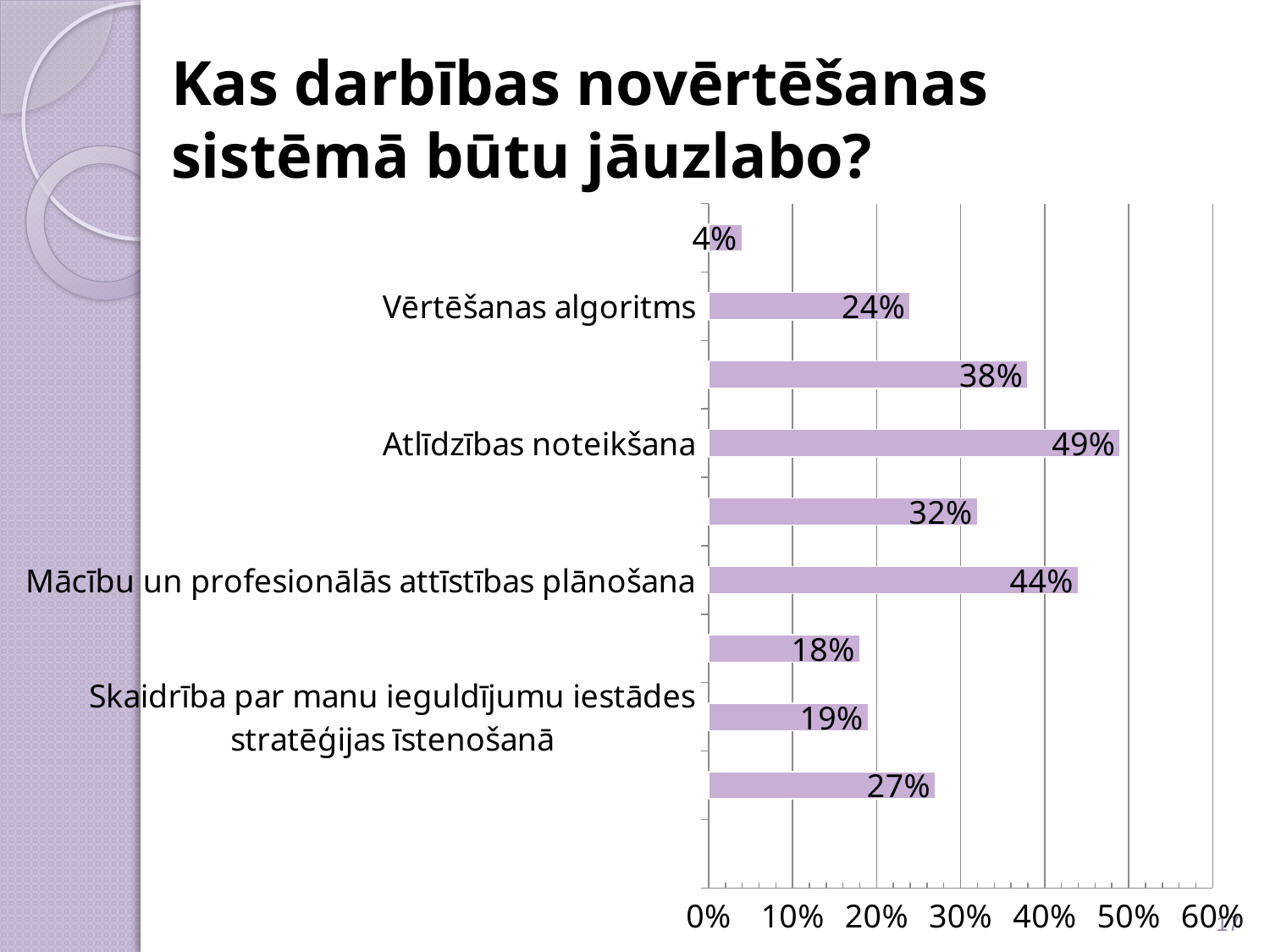
What is the difference between the values for Atlīdzības noteikšana and Mācību un profesionālās attīstības plānošana? 5% What is the title of the slide containing the chart? Kas darbības novērtēšanas sistēmā būtu jāuzlabo? Which is larger, the value for Vērtēšanas algoritms or the value for Skaidrība par manu ieguldījumu iestādes stratēģijas īstenošanā? Vērtēšanas algoritms Is the value for Mācību un profesionālās attīstības plānošana greater or less than 40%? greater What is the value for Vērtēšanas algoritms? 24% What is the value for Mācību un profesionālās attīstības plānošana? 44% Which labelled category has the highest value? Atlīdzības noteikšana What is the value for Atlīdzības noteikšana? 49% What is the smallest value shown on any bar in the chart? 4% What is the value for Skaidrība par manu ieguldījumu iestādes stratēģijas īstenošanā? 19% How many bars are plotted in the chart? 9 What kind of chart is shown on the slide? bar chart